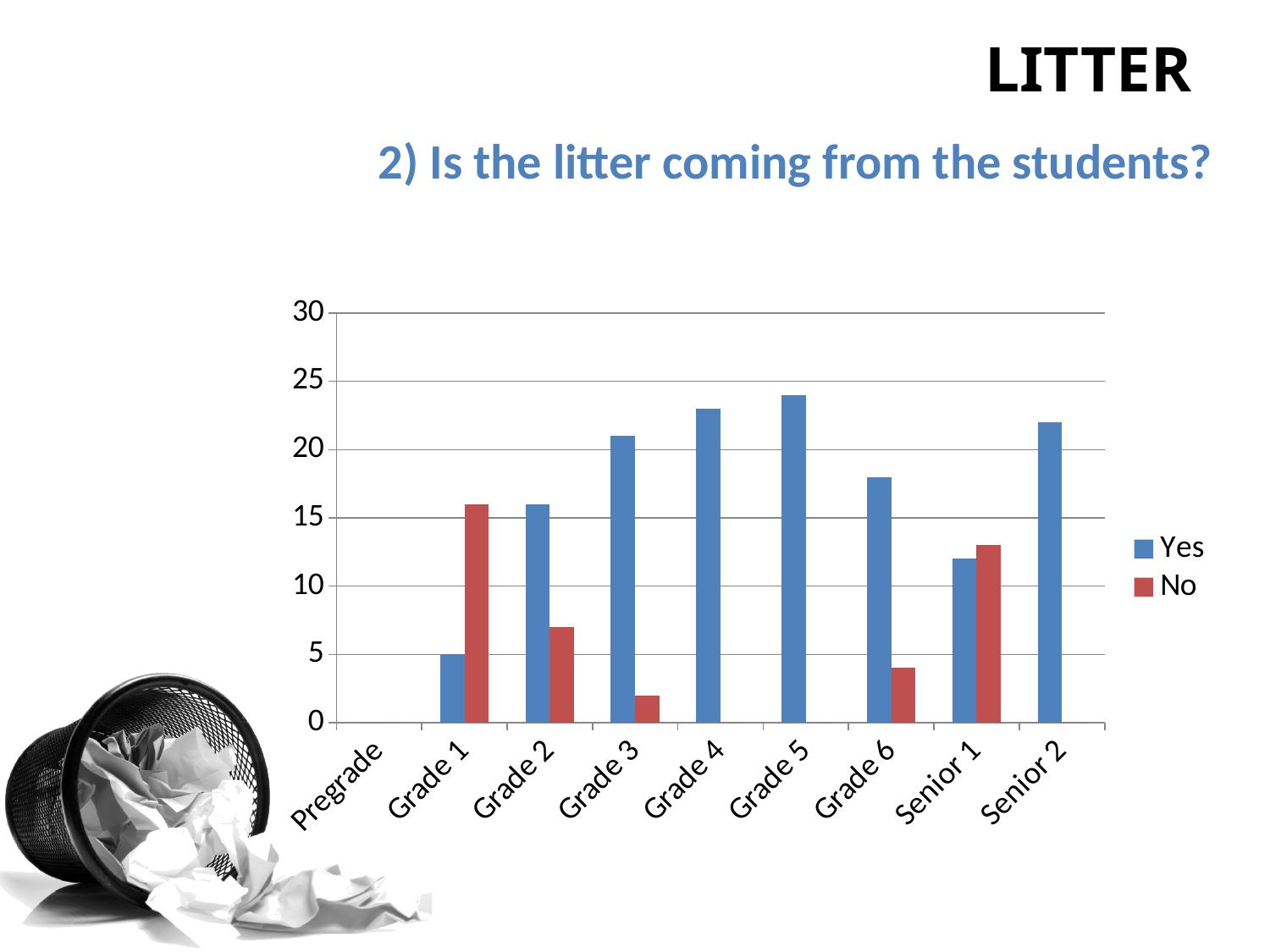
Is the "No" value for Grade 3 greater or less than 5? less How many series does the legend list? 2 What are the two series named in the legend? Yes and No Is the "Yes" value for Senior 2 greater or less than 20? greater For Grade 2, which is larger, the "Yes" value or the "No" value? Yes Is the "Yes" value for Grade 5 greater or less than 20? greater What kind of chart is shown on the slide? bar chart Which category has the highest "No" value? Grade 1 Which colour represents the "Yes" series? blue How many categories are shown on the x axis? 9 For Grade 1, which is larger, the "Yes" value or the "No" value? No